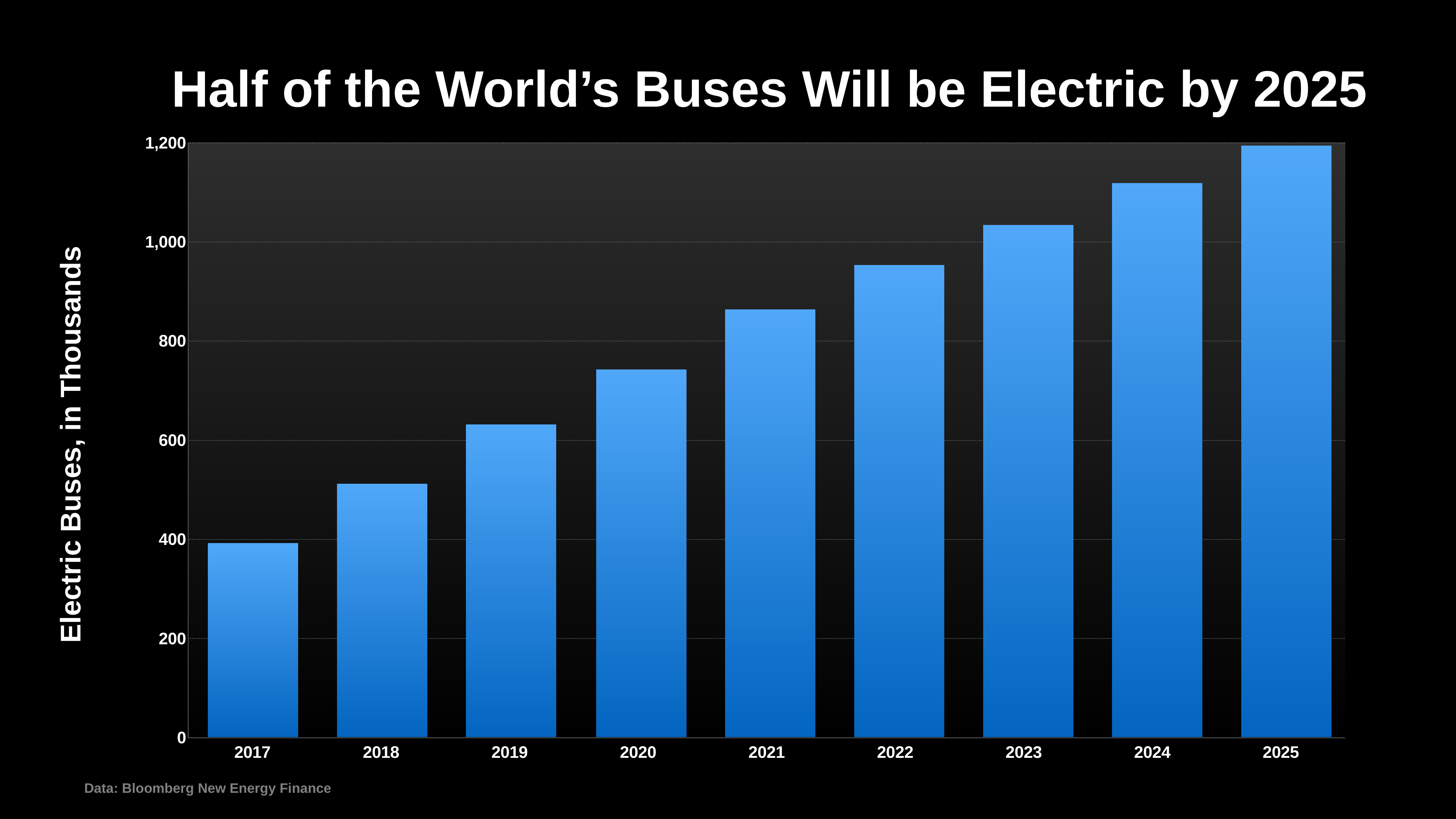
Is the value for 2024 greater or less than 1,000? greater How many years are shown on the x axis? 9 What is the label on the vertical axis? Electric Buses, in Thousands What is the title of the chart? Half of the World's Buses Will be Electric by 2025 Is the value for 2022 greater or less than 1,000? less Which is larger, the value for 2019 or the value for 2023? 2023 Do the values rise or fall from 2017 to 2025? rise Which year has the lowest value? 2017 Is the value for 2021 greater or less than 800? greater Which year has the highest value? 2025 What kind of chart is shown on the slide? bar chart